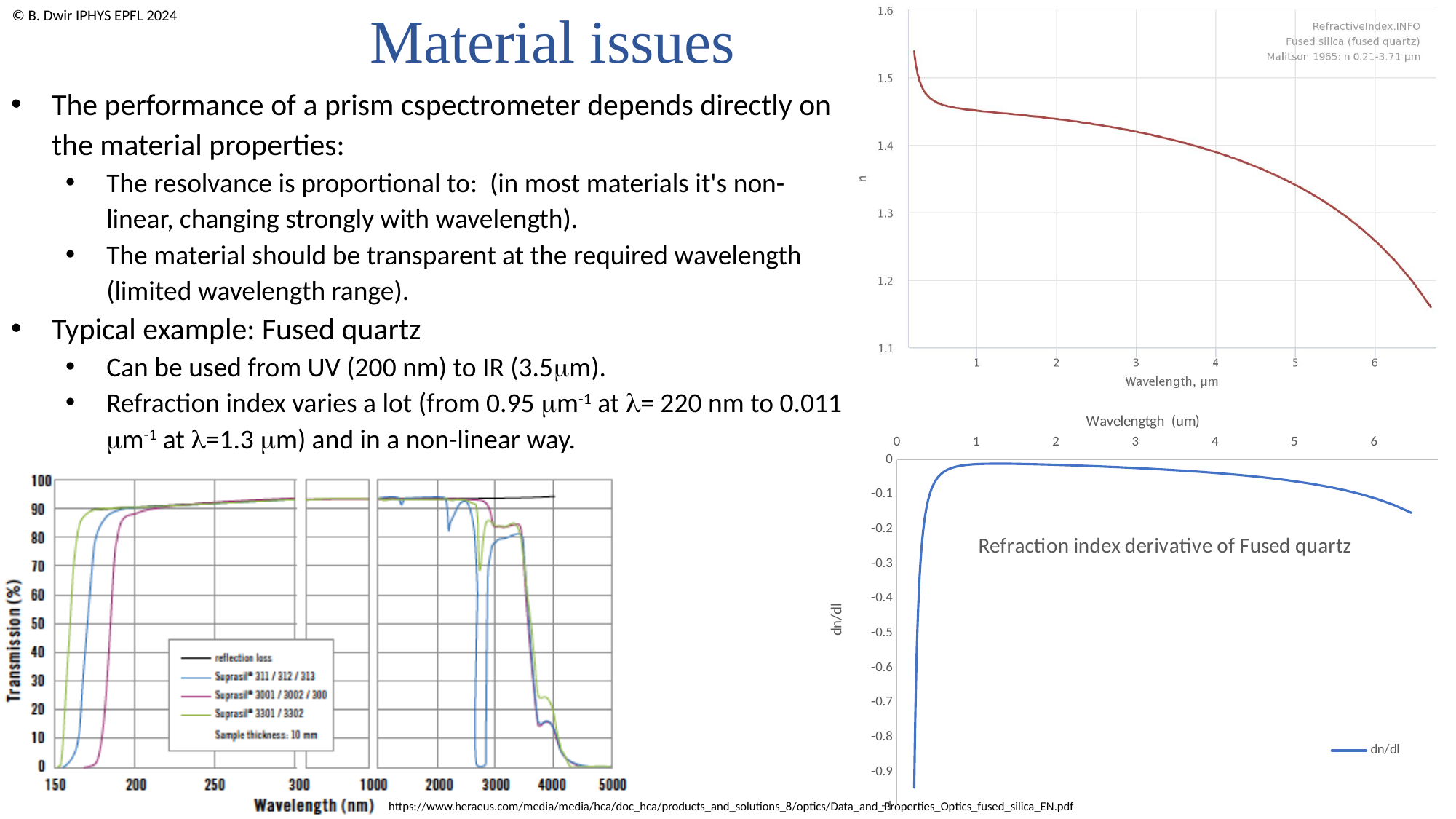
What is the x-axis label of the top-right chart of refractive index n? Wavelength, µm In the bottom-right chart 'Refraction index derivative of Fused quartz', is the value of dn/dl at a wavelength of 1 µm greater or less than -0.1? greater In the bottom-left transmission chart, is the transmission of Suprasil 3301/3302 at 4000 nm greater or less than 50%? less How many entries does the legend of the bottom-left transmission chart list? 4 What kind of chart is the top-right chart of refractive index n versus wavelength? line chart In the bottom-left transmission chart, is the transmission of Suprasil 311/312/313 at 250 nm greater or less than 80%? greater What is the title of the bottom-right chart? Refraction index derivative of Fused quartz In the top-right chart of n versus wavelength, does the refractive index rise or fall as wavelength increases from 1 to 6 µm? fall What kind of chart is the bottom-right chart 'Refraction index derivative of Fused quartz'? line chart How many series does the legend of the bottom-right chart 'Refraction index derivative of Fused quartz' list? 1